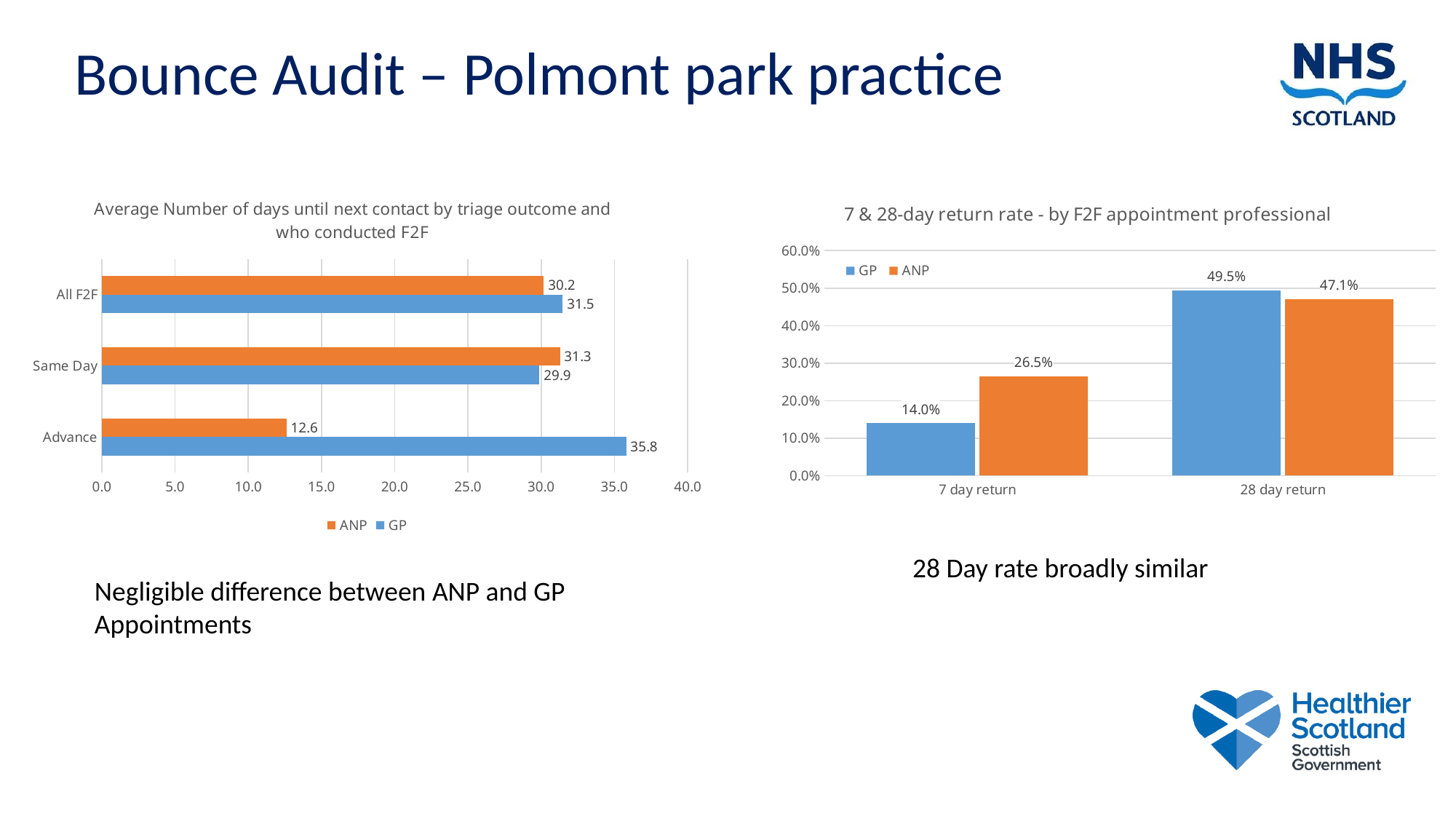
In the right chart (7 & 28-day return rate), what is the difference between the ANP and GP values for 7 day return? 12.5% In the right chart (7 & 28-day return rate), how many series does the legend list? 2 In the left chart (Average Number of days until next contact), what is the ANP value for Advance? 12.6 In the right chart (7 & 28-day return rate), which series is shown in orange? ANP In the left chart (Average Number of days until next contact), how many categories are shown on the vertical axis? 3 In the left chart (Average Number of days until next contact), which is larger for Same Day, ANP or GP? ANP In the right chart (7 & 28-day return rate), what is the ANP value for 28 day return? 47.1% What type of chart is the left chart (Average Number of days until next contact)? Bar chart In the left chart (Average Number of days until next contact), what is the difference between the GP and ANP values for Advance? 23.2 In the left chart (Average Number of days until next contact), what is the GP value for All F2F? 31.5 In the right chart (7 & 28-day return rate), what is the GP value for 7 day return? 14.0% In the left chart (Average Number of days until next contact), which category has the highest GP value? Advance